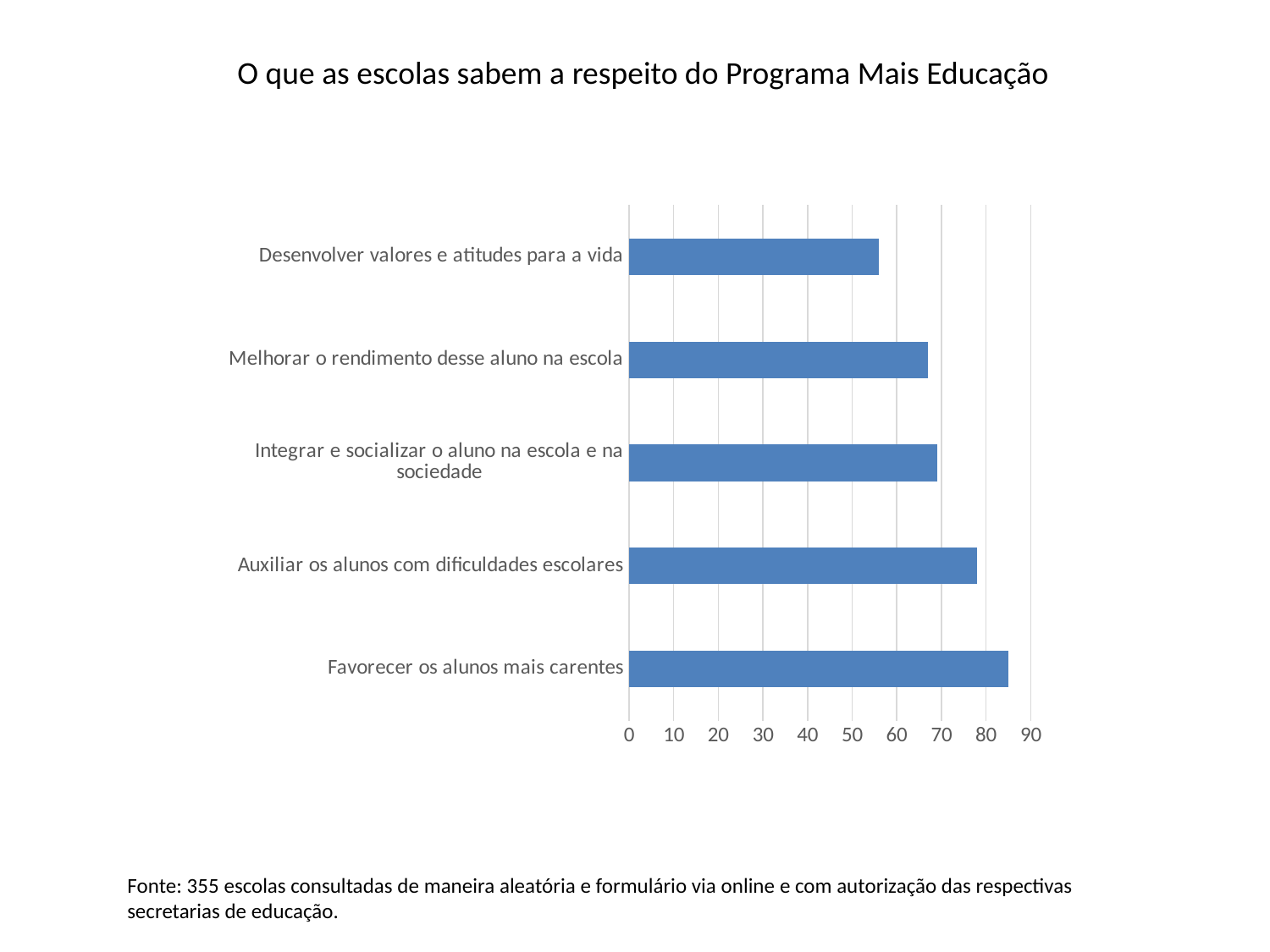
What kind of chart is shown on the slide? bar chart Is the value for Auxiliar os alunos com dificuldades escolares greater or less than 70? greater What is the title of the chart? O que as escolas sabem a respeito do Programa Mais Educação Is the value for Desenvolver valores e atitudes para a vida greater or less than 60? less Which category has the lowest value? Desenvolver valores e atitudes para a vida Is the value for Melhorar o rendimento desse aluno na escola greater or less than 70? less Which is larger: the value for Auxiliar os alunos com dificuldades escolares or the value for Desenvolver valores e atitudes para a vida? Auxiliar os alunos com dificuldades escolares Which category has the highest value? Favorecer os alunos mais carentes How many categories are shown in the chart? 5 What is the highest tick value shown on the horizontal axis? 90